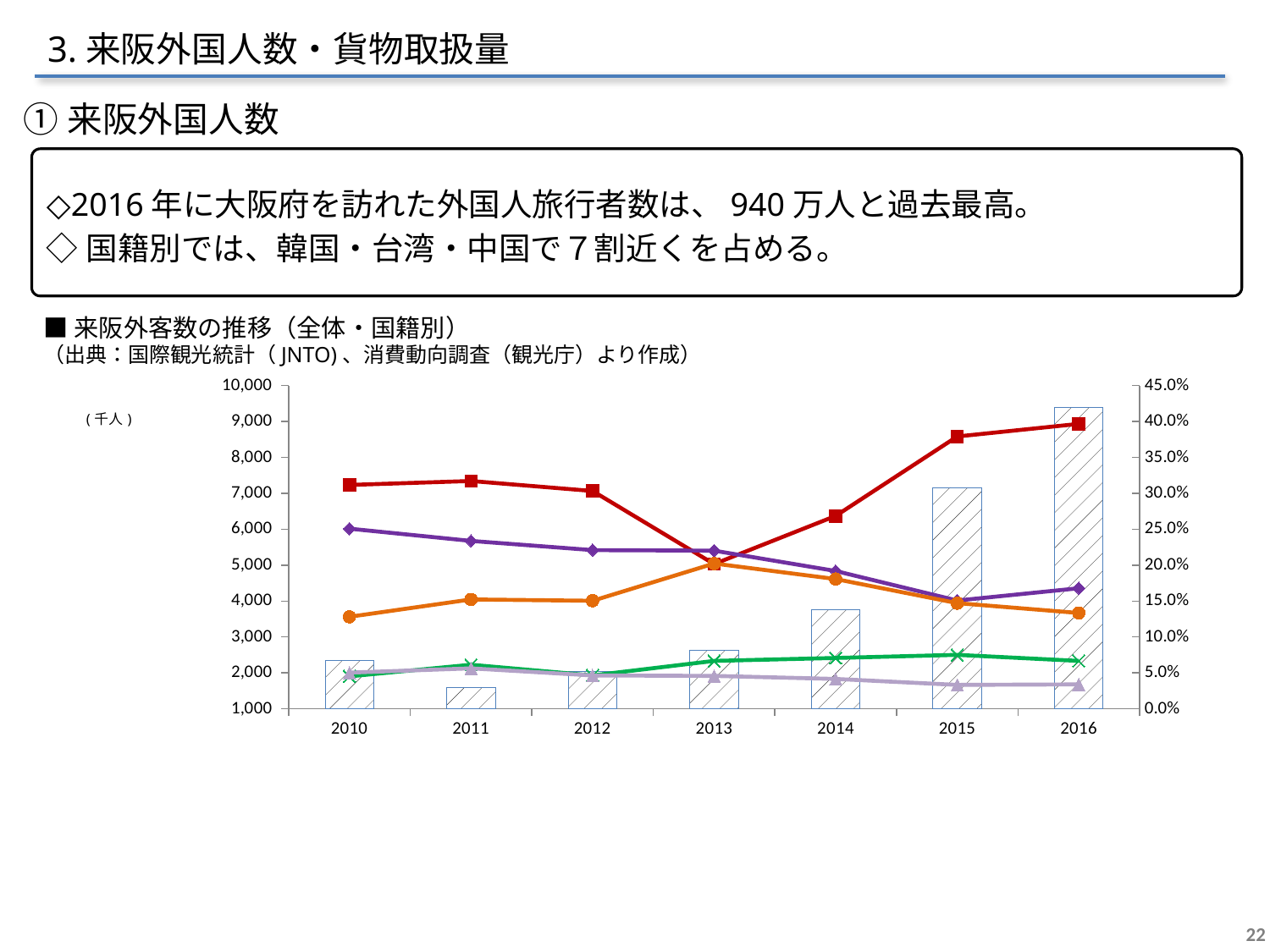
Which year has the taller bar, 2013 or 2014? 2014 Is the bar value for 2015 greater or less than 6,000? greater Which year has the tallest bar in the chart? 2016 Is the bar value for 2011 greater or less than 2,000? less How many years are shown along the x axis of the chart? 7 Do the bars rise or fall from 2013 to 2016? rise Is the bar value for 2014 greater or less than 4,000? less What unit is shown for the left axis of the chart? 千人 What kind of chart is shown on the slide? A combination bar and line chart Which year has the shortest bar in the chart? 2011